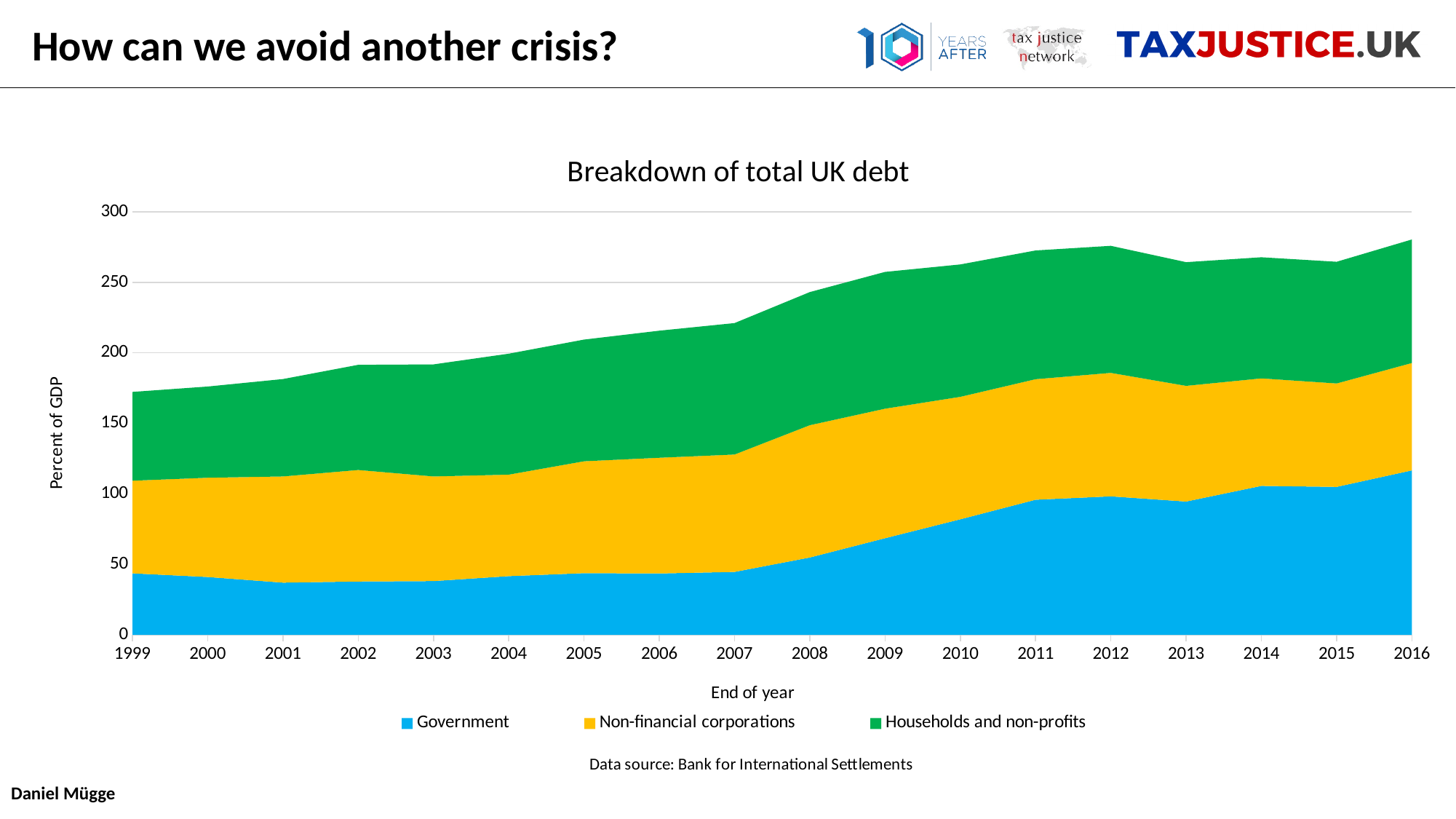
Is the total UK debt for 2016 greater or less than 250? greater Is the Government value for 2016 greater or less than 100? greater Does the total UK debt rise or fall from 1999 to 2016? rise What kind of chart is shown on the slide? Stacked area chart How many years are shown along the x axis? 18 What is the label on the y axis? Percent of GDP How many series does the legend list? 3 Is the Government value for 2011 greater or less than 100? less Which is larger, the Government value for 2016 or for 1999? 2016 Which year has the lowest total UK debt? 1999